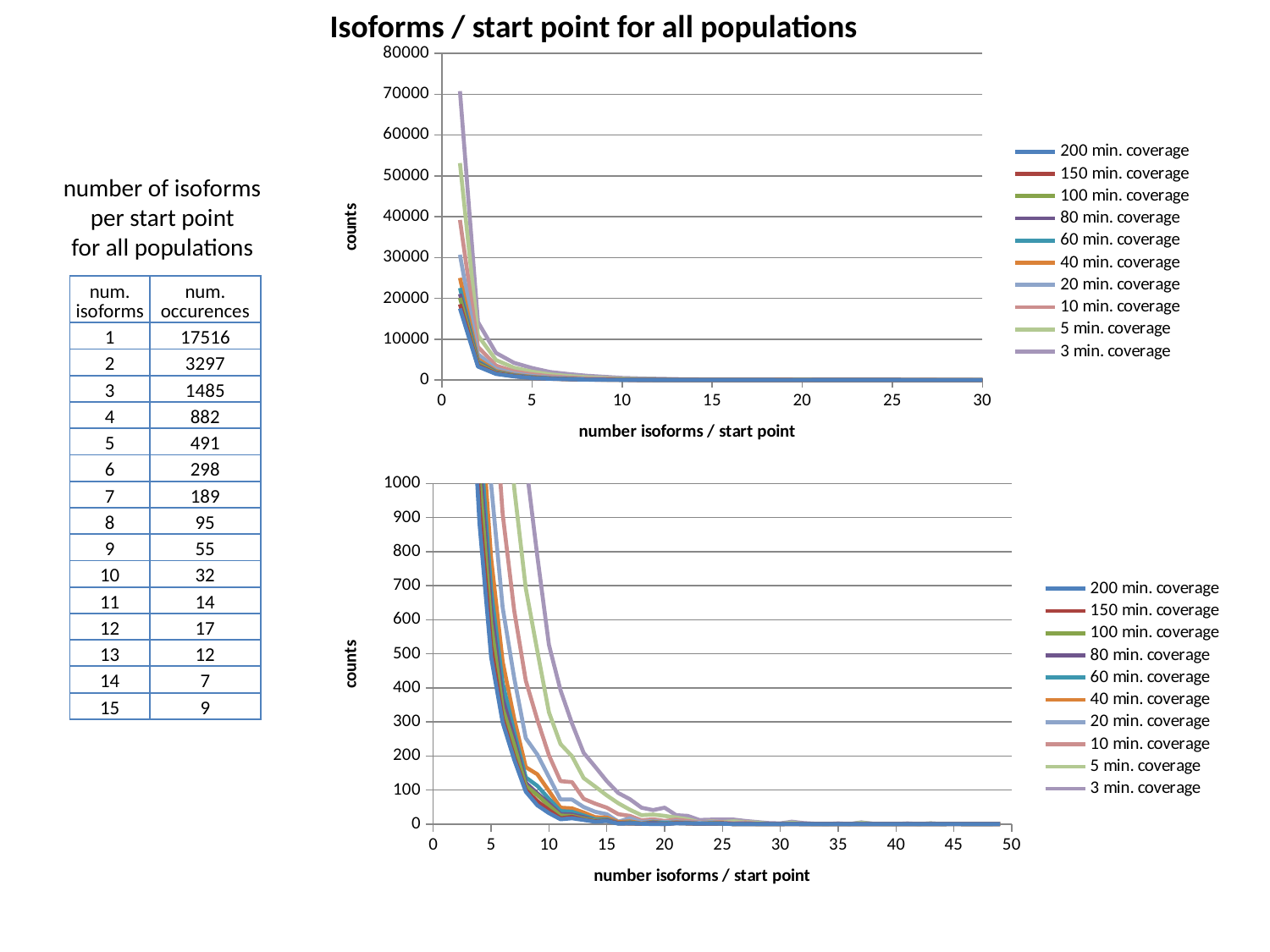
In the bottom chart, is the value for 3 min. coverage at 10 isoforms per start point greater or less than 300? greater What is the highest value shown on the y axis of the bottom chart? 1000 How many series does the legend of the top chart list? 10 In the top chart, is the value for 5 min. coverage at 1 isoform per start point greater or less than 40000? greater In the top chart, which series has the lowest count at 1 isoform per start point? 200 min. coverage In the top chart, which series has the highest count at 1 isoform per start point? 3 min. coverage In the top chart, do the counts rise or fall as the number of isoforms per start point increases? fall How many series does the legend of the bottom chart list? 10 In the bottom chart, at 10 isoforms per start point, which is larger: 3 min. coverage or 5 min. coverage? 3 min. coverage What kind of chart is the top chart titled 'Isoforms / start point for all populations'? line chart What is the label of the y axis on the bottom chart? counts In the top chart, is the value for 3 min. coverage at 1 isoform per start point greater or less than 60000? greater